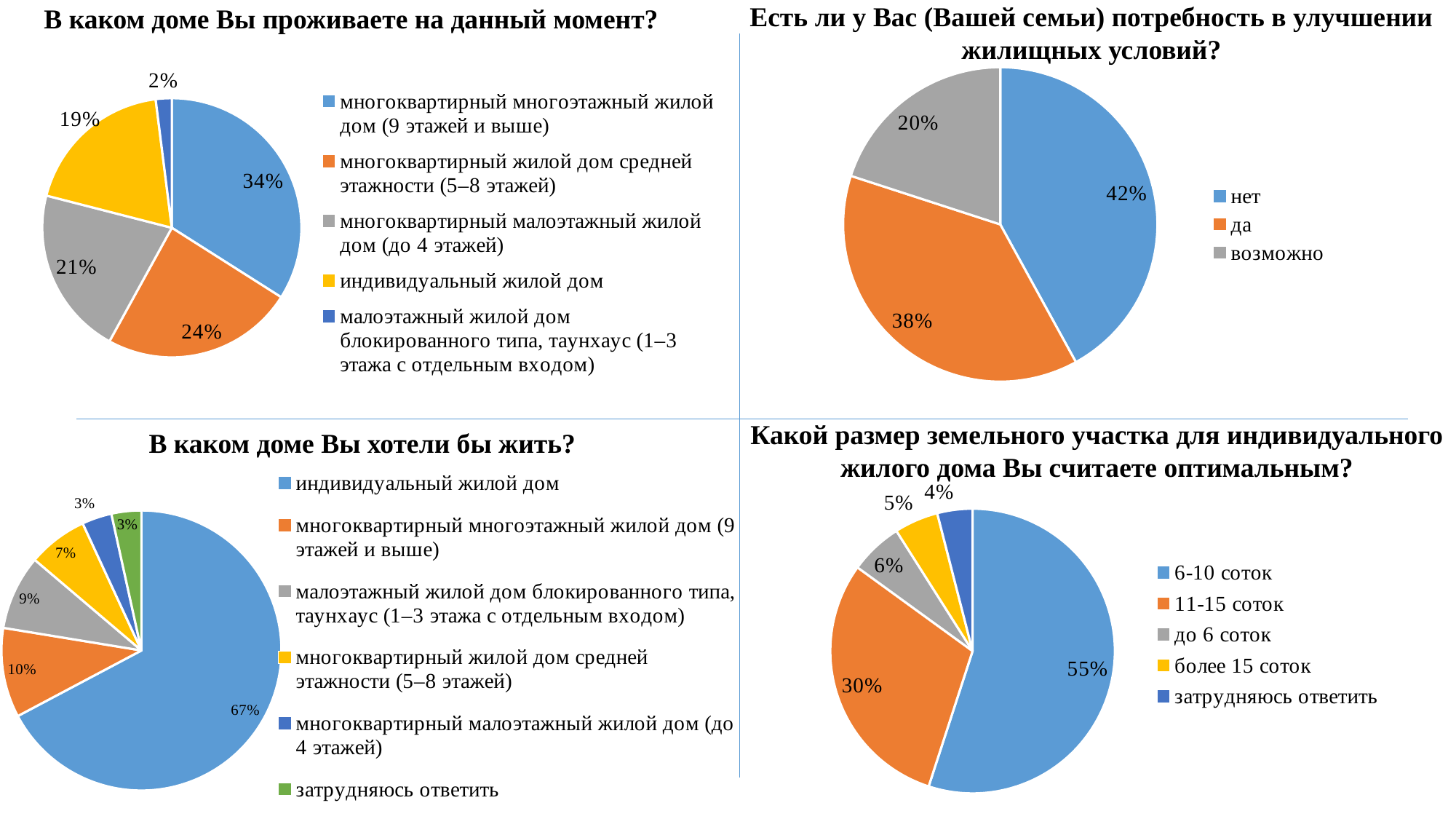
In the chart "Какой размер земельного участка для индивидуального жилого дома Вы считаете оптимальным?", what share is shown for "11-15 соток"? 30% How many categories are shown in the chart "В каком доме Вы хотели бы жить?"? 6 In the chart "В каком доме Вы хотели бы жить?", what share is shown for "индивидуальный жилой дом"? 67% In the chart "Какой размер земельного участка для индивидуального жилого дома Вы считаете оптимальным?", what is the difference between the shares for "6-10 соток" and "11-15 соток"? 25% In the chart "Есть ли у Вас (Вашей семьи) потребность в улучшении жилищных условий?", what share answered "да"? 38% What type of chart is used for "Какой размер земельного участка для индивидуального жилого дома Вы считаете оптимальным?"? pie chart How many entries does the legend list in the chart "Есть ли у Вас (Вашей семьи) потребность в улучшении жилищных условий?"? 3 In the chart "В каком доме Вы проживаете на данный момент?", what is the difference between the shares for "многоквартирный жилой дом средней этажности (5–8 этажей)" and "многоквартирный малоэтажный жилой дом (до 4 этажей)"? 3% In the chart "В каком доме Вы хотели бы жить?", which is larger: the share for "многоквартирный многоэтажный жилой дом (9 этажей и выше)" or for "многоквартирный жилой дом средней этажности (5–8 этажей)"? многоквартирный многоэтажный жилой дом (9 этажей и выше) In the chart "В каком доме Вы проживаете на данный момент?", which category has the largest share? многоквартирный многоэтажный жилой дом (9 этажей и выше) In the chart "В каком доме Вы проживаете на данный момент?", what share is shown for "индивидуальный жилой дом"? 19% In the chart "Есть ли у Вас (Вашей семьи) потребность в улучшении жилищных условий?", which answer has the smallest share? возможно